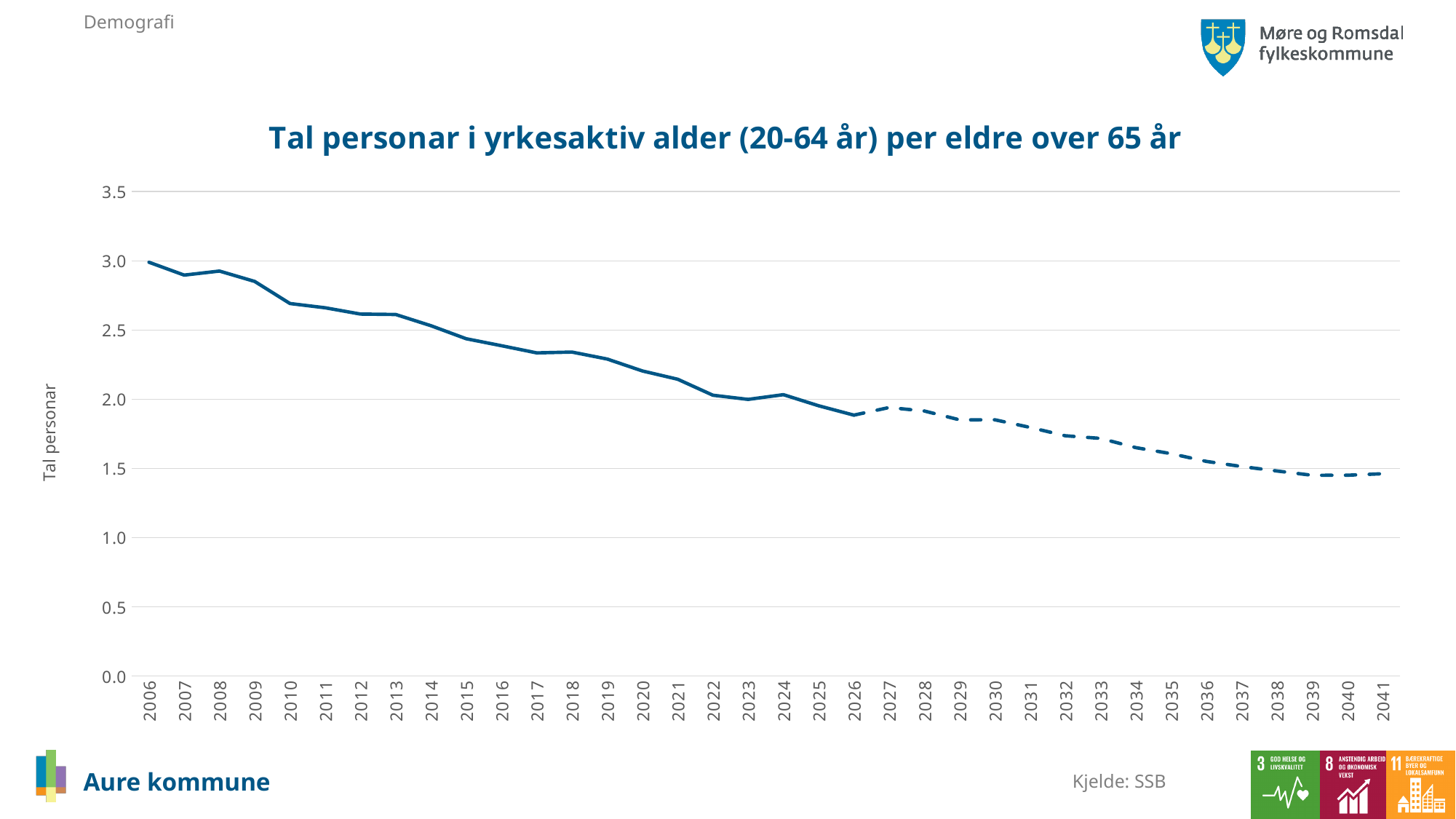
Which year has the larger value, 2015 or 2025? 2015 How many years are shown along the x axis of the chart? 36 Is the value for 2020 greater or less than 2.5? less Is the value for 2035 greater or less than 1.5? greater Do the values generally rise or fall from 2006 to 2041? fall Is the value for 2026 greater or less than 2.0? less Which year has the highest value in the chart? 2006 What is the label on the vertical axis of the chart? Tal personar What is the title of the chart? Tal personar i yrkesaktiv alder (20-64 år) per eldre over 65 år What kind of chart is shown on the slide? line chart